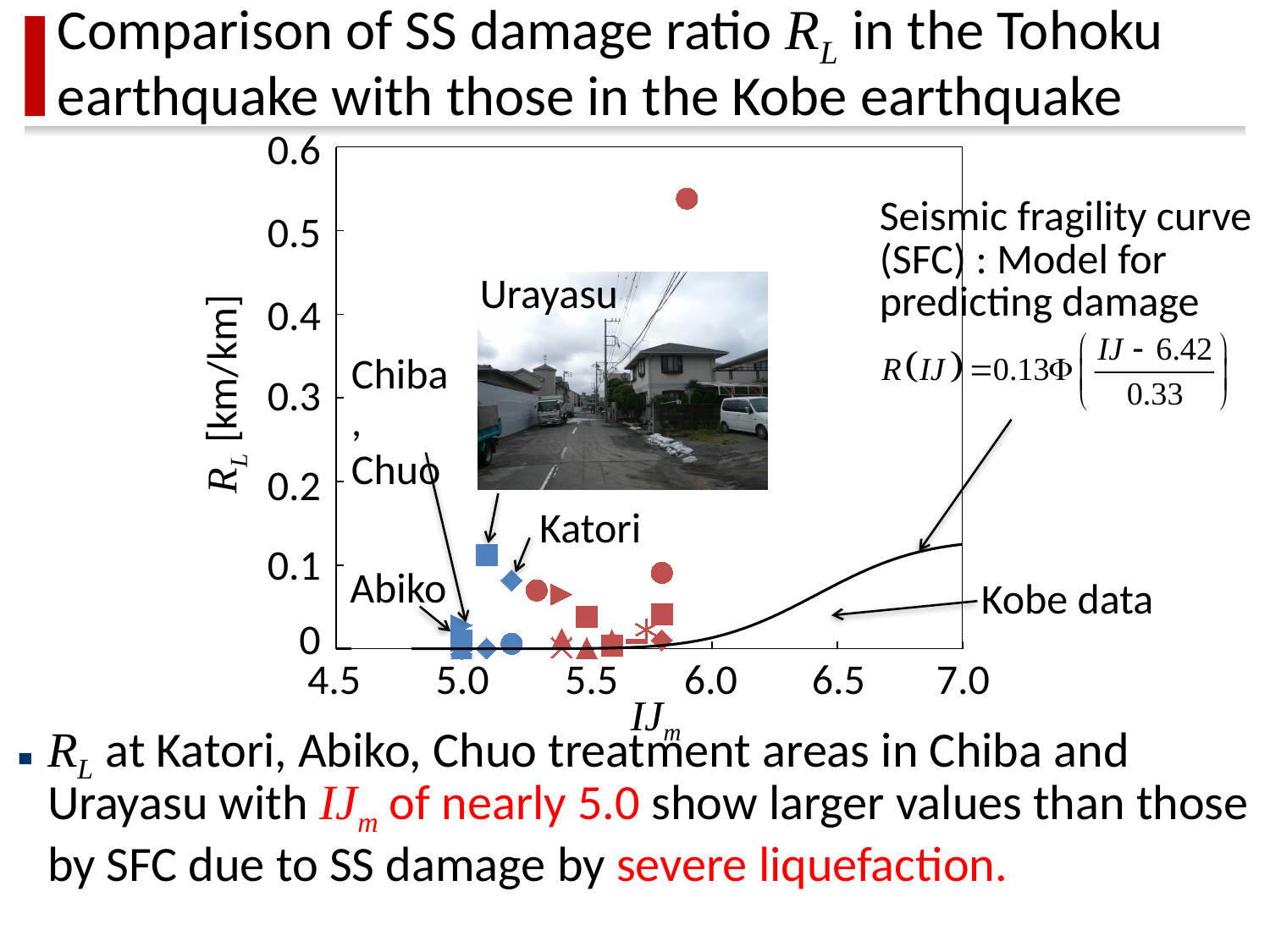
Is the R_L value of the Katori point greater or less than 0.2? less Is the value of the seismic fragility curve at IJ_m = 7.0 greater or less than 0.2? less Is the IJ_m value of the Urayasu point greater or less than 5.5? less Does the seismic fragility curve (SFC) rise or fall as IJ_m increases from 6.0 to 7.0? rise What is the maximum value shown on the vertical axis of the chart? 0.6 What is the label of the vertical axis of the chart? R_L [km/km] What is the label of the horizontal axis of the chart? IJ_m What kind of chart is shown on the slide? scatter chart